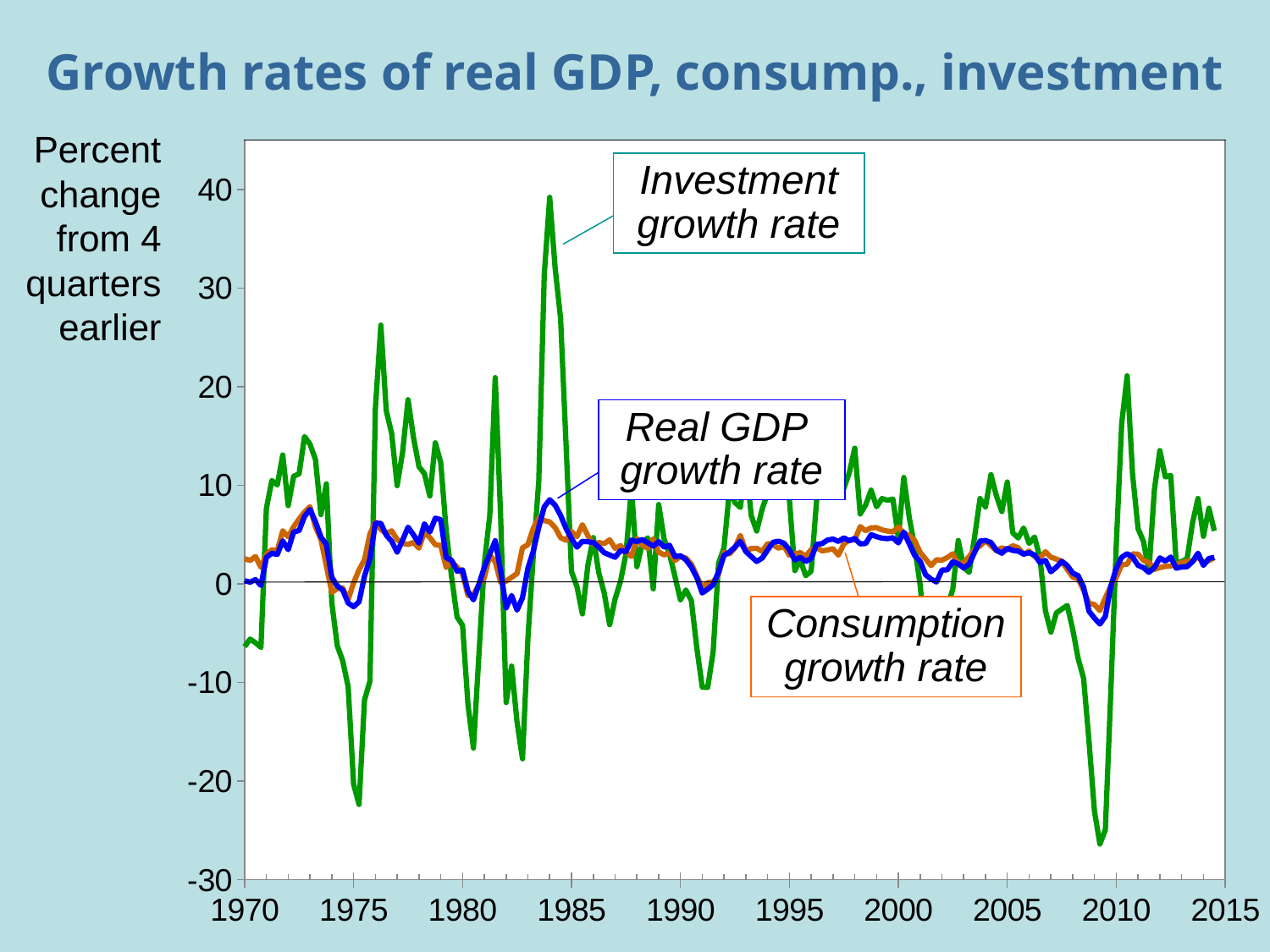
Around 1984, which is larger: the investment growth rate or the real GDP growth rate? Investment growth rate Is the lowest value of the investment growth rate around 2009 greater or less than -20? less How many data series are plotted on the chart? 3 Which series reaches the lowest value on the chart? Investment growth rate Which series is drawn in green? Investment growth rate Is the investment growth rate around 1975 greater or less than -10? less What is the title of the chart? Growth rates of real GDP, consump., investment Is the peak value of the investment growth rate around 1984 greater or less than 30? greater Which series reaches the highest value on the chart? Investment growth rate What kind of chart is shown on the slide? line chart What is the first year shown on the x axis? 1970